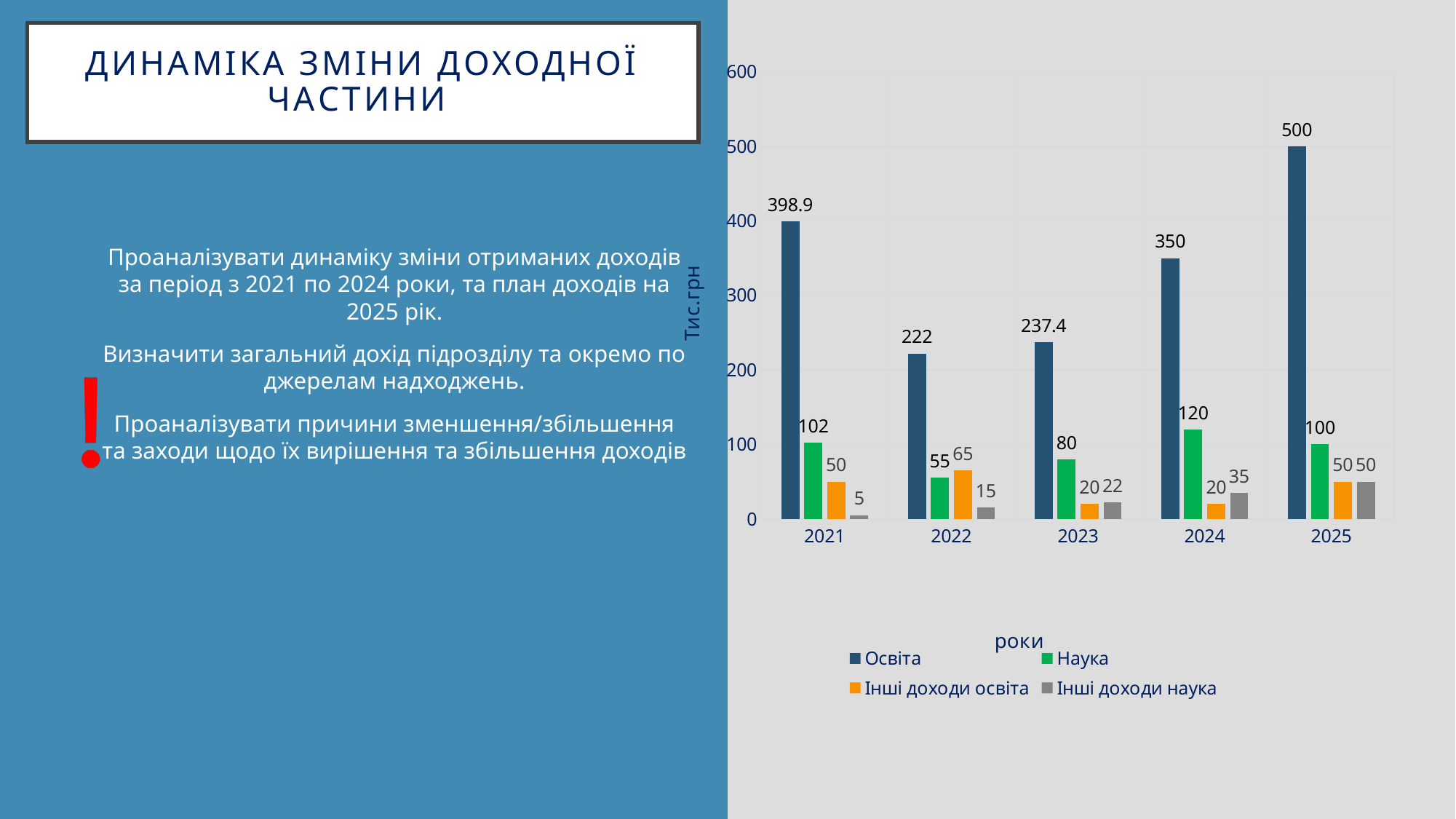
Which is larger in 2022: Наука or Інші доходи освіта? Інші доходи освіта What is the value for Інші доходи наука in 2021? 5 How many years are shown on the x axis? 5 What is the value for Наука in 2024? 120 What is the difference between the Освіта values for 2025 and 2024? 150 What is the value for Освіта in 2021? 398.9 In which year is the value for Освіта highest? 2025 In which year is the value for Освіта lowest? 2022 What kind of chart is shown on the slide? Bar chart What is the value for Інші доходи освіта in 2022? 65 What is the label of the vertical axis? Тис.грн How many series does the legend list? 4